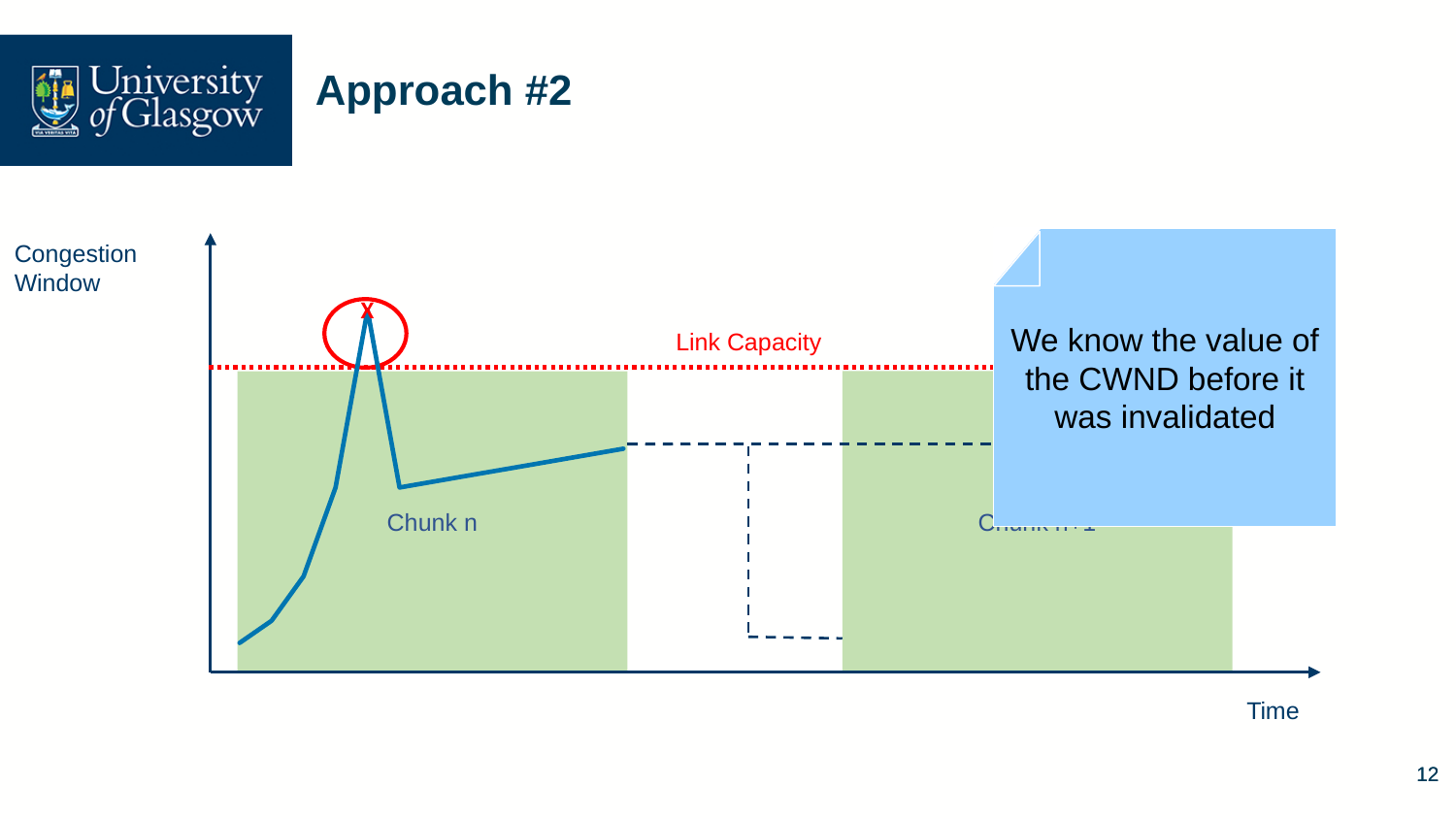
How many green shaded chunk regions are drawn on the chart? 2 What kind of chart is shown on the slide? line chart After the sharp drop following the peak in Chunk n, does the line rise or fall as time goes on? rise What is the label on the vertical axis? Congestion Window What does the red dotted horizontal line represent? Link Capacity Is the peak of the line marked with the red X above or below the Link Capacity line? above At the start of the chart, does the congestion window line rise or fall over time? rise